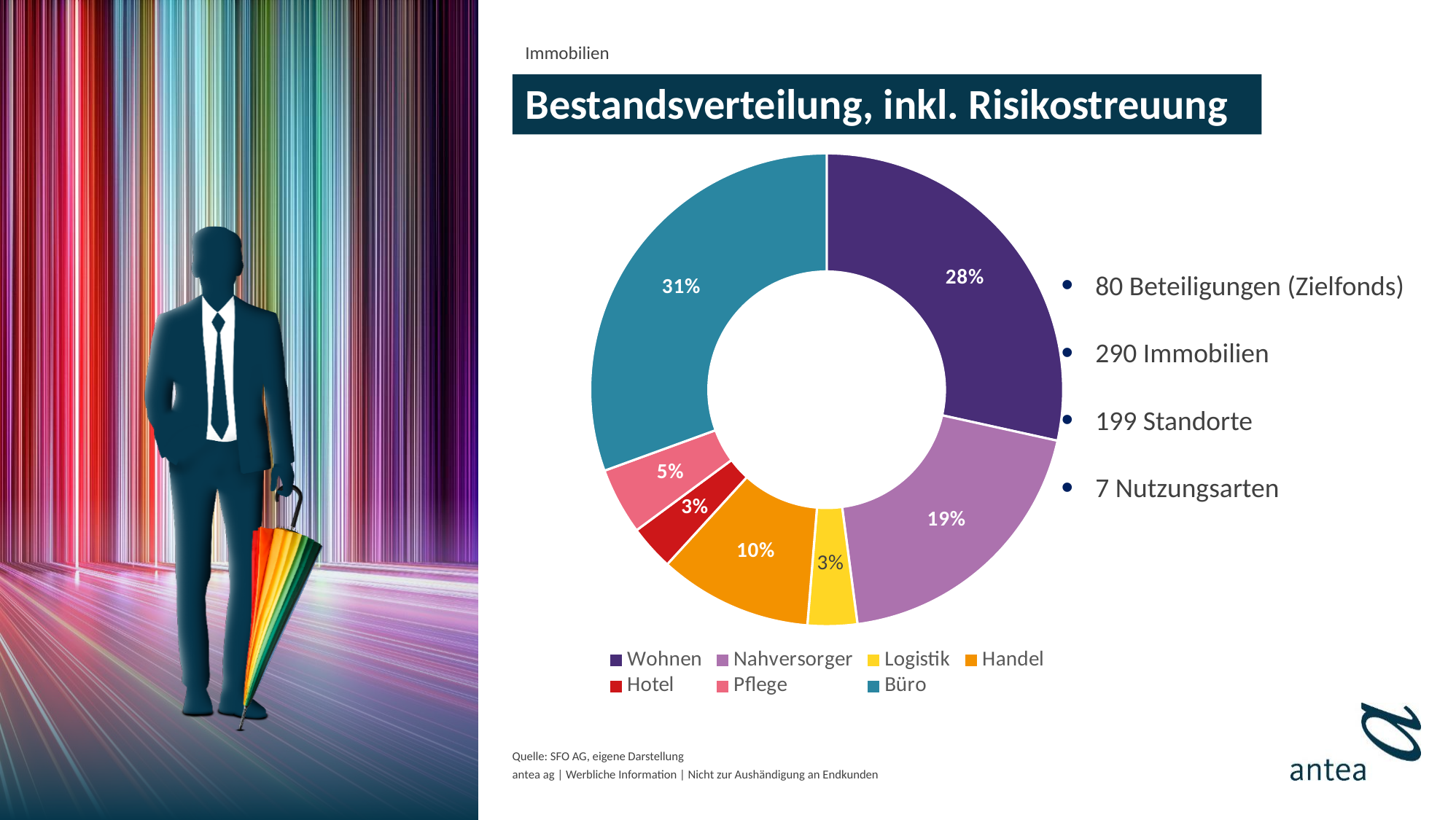
What is the value for Nahversorger? 19% What share of the chart does Büro account for? 31% What percentage does Handel represent? 10% Which is larger, the share for Nahversorger or the share for Handel? Nahversorger What percentage is shown for Wohnen? 28% What is the title of the chart on the slide? Bestandsverteilung, inkl. Risikostreuung What is the combined share of Logistik and Hotel? 6% What is the difference in percentage points between Büro and Wohnen? 3 What is the share for Pflege? 5% What kind of chart is shown on the slide? doughnut chart How many categories are shown in the chart? 7 Which category has the largest share in the chart? Büro